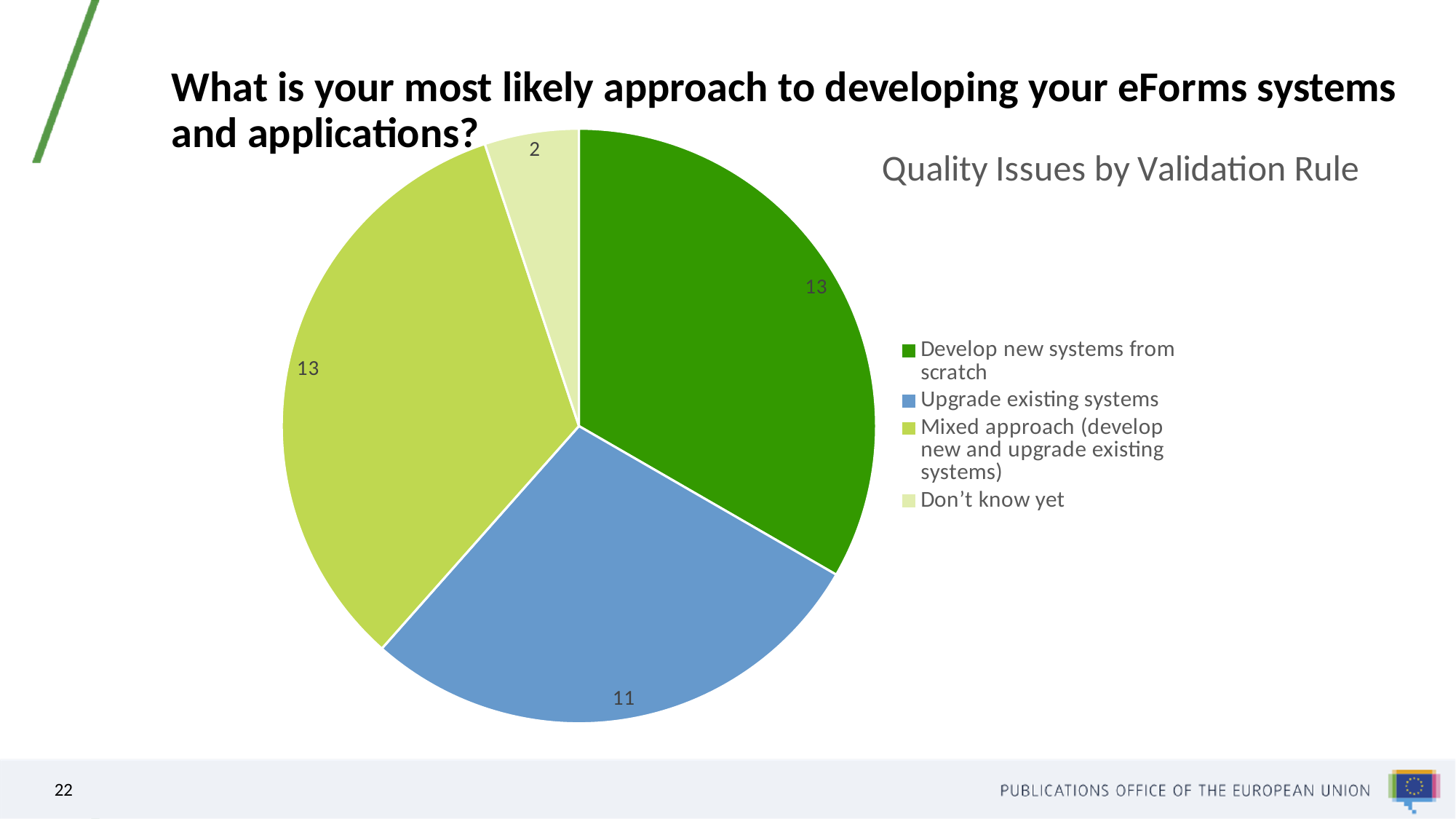
What is the total of all the values in the pie chart? 39 What is the value for 'Don't know yet'? 2 What is the difference between the values for 'Develop new systems from scratch' and 'Upgrade existing systems'? 2 How many categories does the pie chart have? 4 What is the value for 'Upgrade existing systems'? 11 What is the title shown next to the pie chart? Quality Issues by Validation Rule Which is larger: the value for 'Mixed approach (develop new and upgrade existing systems)' or the value for 'Upgrade existing systems'? Mixed approach (develop new and upgrade existing systems) What is the value for 'Develop new systems from scratch'? 13 What is the difference between the values for 'Upgrade existing systems' and 'Don't know yet'? 9 Which category has the smallest slice of the pie? Don't know yet What type of chart is shown on the slide? pie chart What is the value for 'Mixed approach (develop new and upgrade existing systems)'? 13